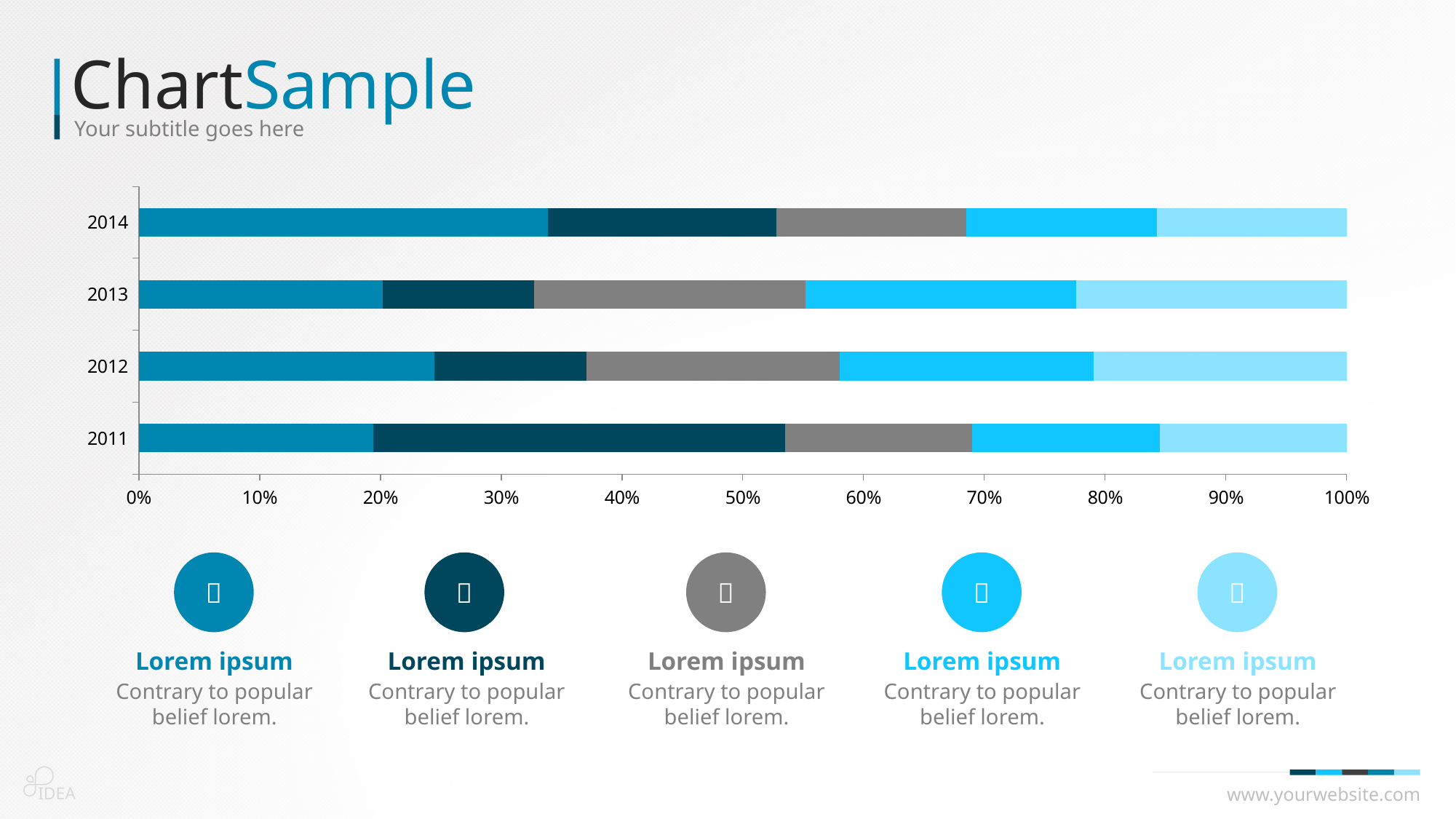
What is the total of the stacked bar for 2014, as read from the axis? 100% What is the title of the slide containing the chart? ChartSample Is the first (dark teal) segment of the 2012 bar greater or less than 30%? less How many years (categories) are plotted on the chart? 4 Is the first (dark teal) segment of the 2014 bar greater or less than 30%? greater Which is larger: the first (dark teal) segment for 2014 or for 2011? 2014 Which year has the largest second (dark navy) segment? 2011 Is the first (dark teal) segment of the 2011 bar greater or less than 30%? less What kind of chart is shown on the slide? Stacked bar chart Which year has the largest first (dark teal) segment? 2014 What is the highest value shown on the horizontal axis? 100% How many coloured segments make up each bar in the chart? 5